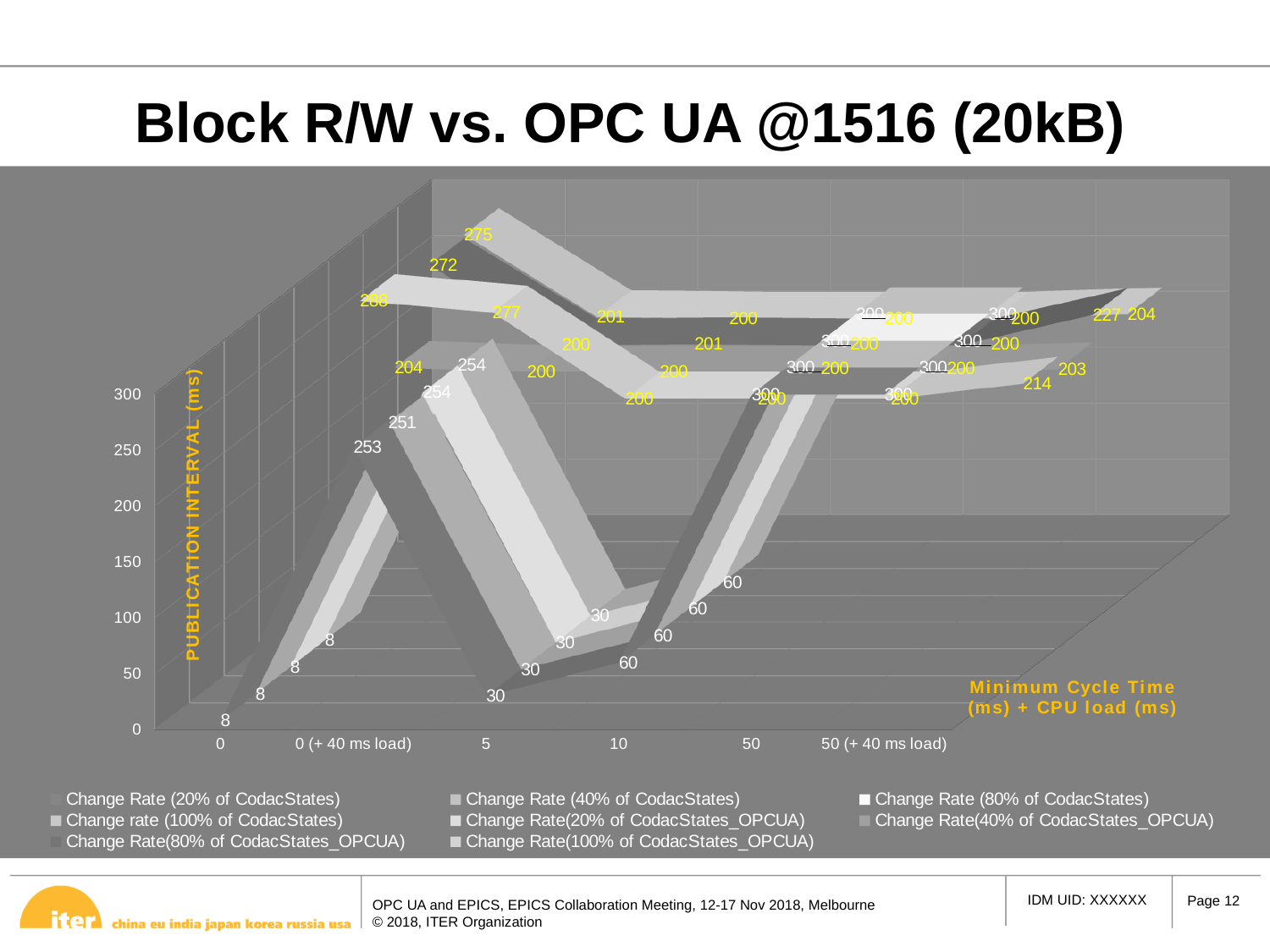
What is the title of the vertical axis of the chart? PUBLICATION INTERVAL (ms) At which x-axis category is the value of Change Rate (20% of CodacStates) lowest? 0 Does the value of Change Rate (20% of CodacStates) rise or fall from minimum cycle time 5 to minimum cycle time 10? rise How many series does the chart legend list? 8 What is the value of Change Rate (40% of CodacStates) at minimum cycle time 5? 30 What is the value of Change Rate (20% of CodacStates) at minimum cycle time 0? 8 At minimum cycle time 5, which is larger: Change Rate (20% of CodacStates) or Change Rate(20% of CodacStates_OPCUA)? Change Rate(20% of CodacStates_OPCUA) How many categories are shown on the x axis of the chart? 6 What is the difference between the values of Change Rate (20% of CodacStates) at minimum cycle time 10 and at minimum cycle time 5? 30 What is the highest tick value shown on the vertical axis? 300 What is the value of Change Rate (80% of CodacStates) at minimum cycle time 10? 60 Is the value for Change Rate(20% of CodacStates_OPCUA) at minimum cycle time 5 greater or less than 150? greater